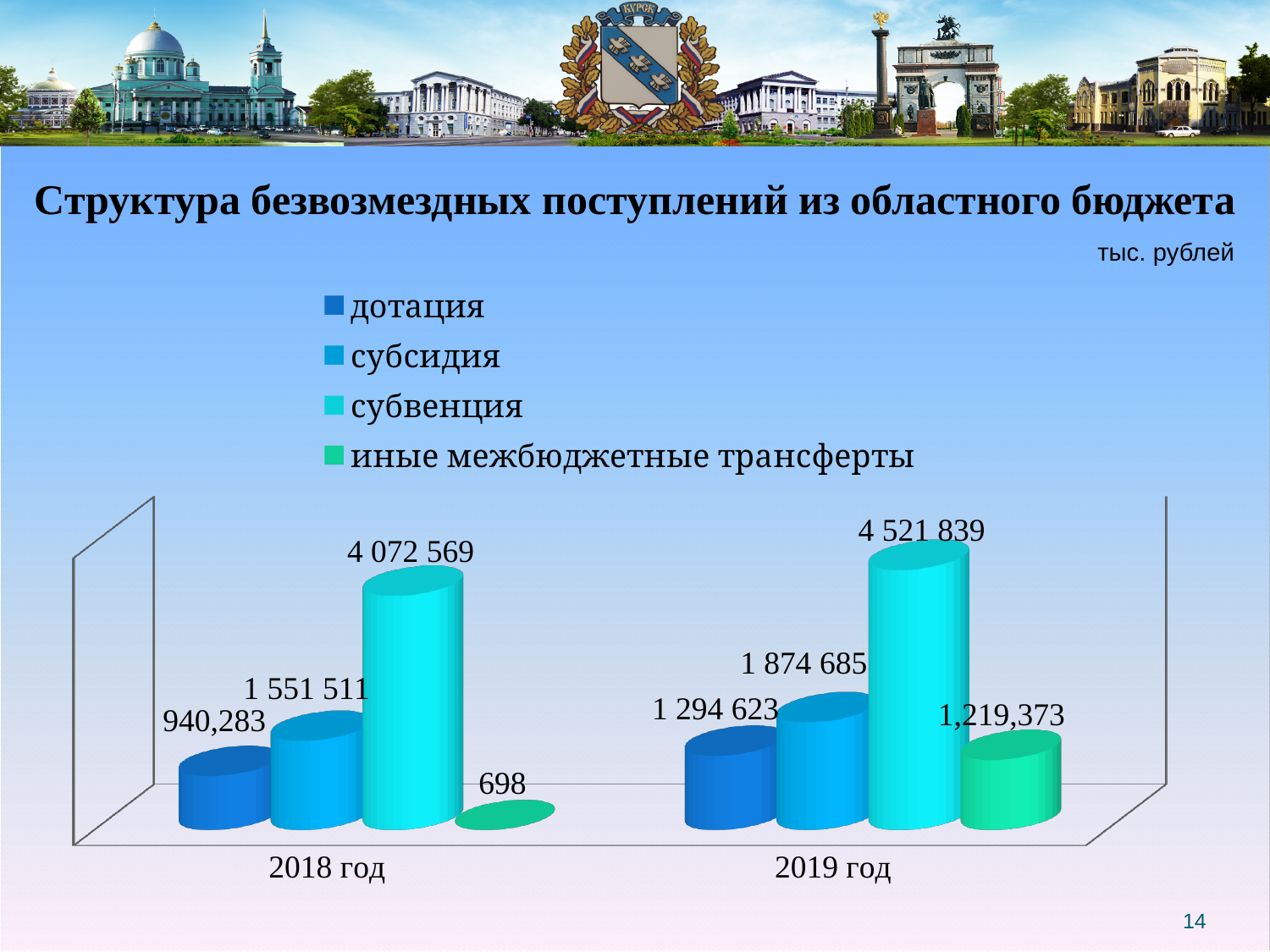
How many series does the legend list? 4 What is the value for иные межбюджетные трансферты in 2018 год? 698 Which is larger: дотация in 2018 год or дотация in 2019 год? дотация in 2019 год Which series has the lowest value in 2018 год? иные межбюджетные трансферты What is the value for субвенция in 2018 год? 4 072 569 Which series has the highest value in 2019 год? субвенция What unit is stated for the values on the chart? тыс. рублей What is the value for дотация in 2019 год? 1 294 623 What is the difference between the субвенция values for 2019 год and 2018 год? 449 270 What is the value for субсидия in 2019 год? 1 874 685 What kind of chart is shown on the slide? bar chart What is the difference between the субсидия values for 2019 год and 2018 год? 323 174